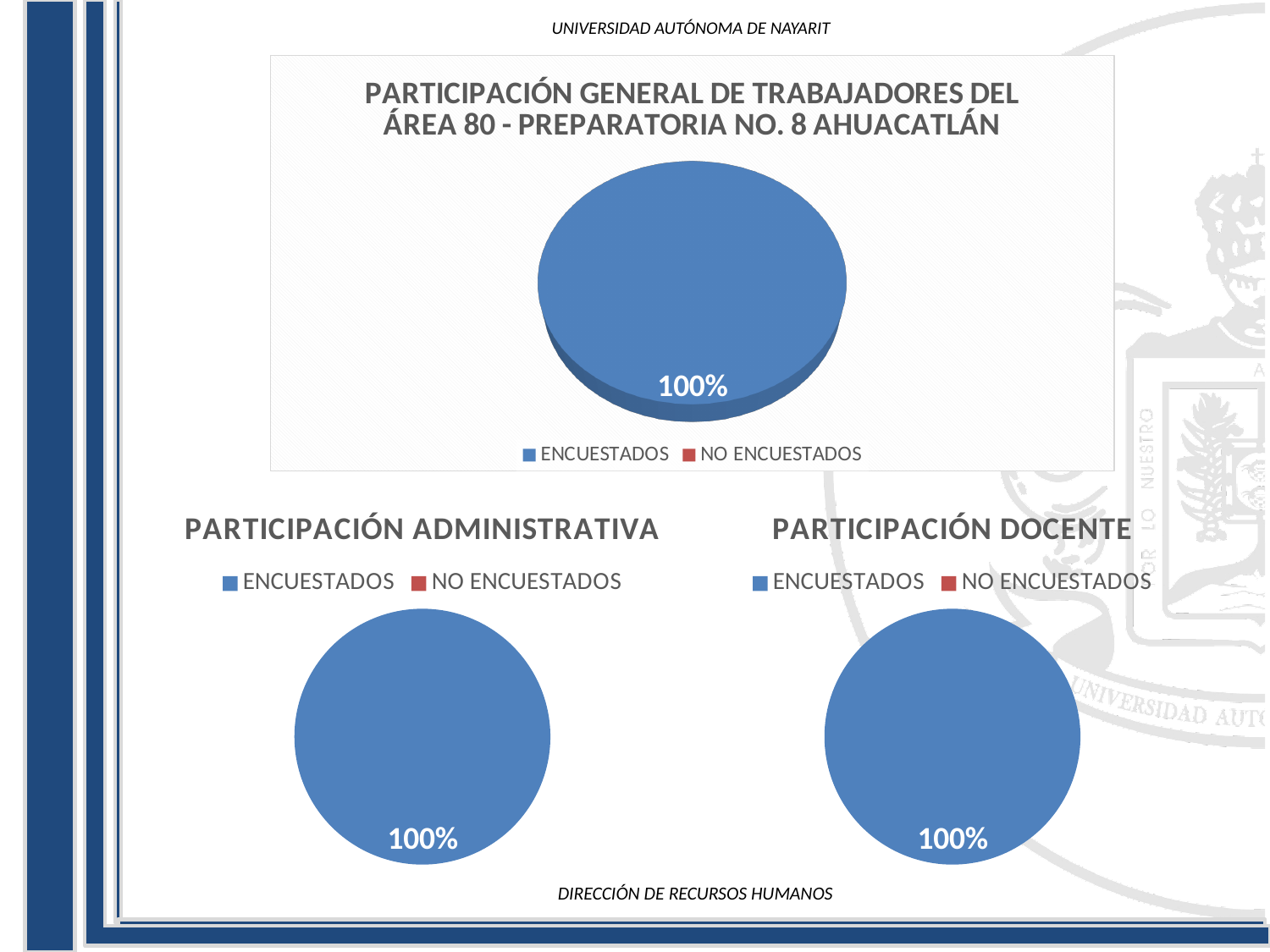
What colour represents NO ENCUESTADOS in the legend of the 'PARTICIPACIÓN DOCENTE' chart? Red In the 'PARTICIPACIÓN GENERAL DE TRABAJADORES DEL ÁREA 80 - PREPARATORIA NO. 8 AHUACATLÁN' chart, which category has the smallest share? NO ENCUESTADOS In the 'PARTICIPACIÓN DOCENTE' chart, what value is shown for ENCUESTADOS? 100% How many entries does the legend of the 'PARTICIPACIÓN GENERAL DE TRABAJADORES DEL ÁREA 80 - PREPARATORIA NO. 8 AHUACATLÁN' chart list? 2 What kind of chart is the 'PARTICIPACIÓN GENERAL DE TRABAJADORES DEL ÁREA 80 - PREPARATORIA NO. 8 AHUACATLÁN' chart? Pie chart In the chart titled 'PARTICIPACIÓN GENERAL DE TRABAJADORES DEL ÁREA 80 - PREPARATORIA NO. 8 AHUACATLÁN', what share of the pie is ENCUESTADOS? 100% In the 'PARTICIPACIÓN DOCENTE' chart, which category is larger, ENCUESTADOS or NO ENCUESTADOS? ENCUESTADOS How many charts are shown on the slide? 3 How many entries does the legend of the 'PARTICIPACIÓN ADMINISTRATIVA' chart list? 2 In the 'PARTICIPACIÓN ADMINISTRATIVA' chart, what value is shown for ENCUESTADOS? 100% In the 'PARTICIPACIÓN ADMINISTRATIVA' chart, which category has the largest share? ENCUESTADOS What kind of chart is the 'PARTICIPACIÓN DOCENTE' chart? Pie chart